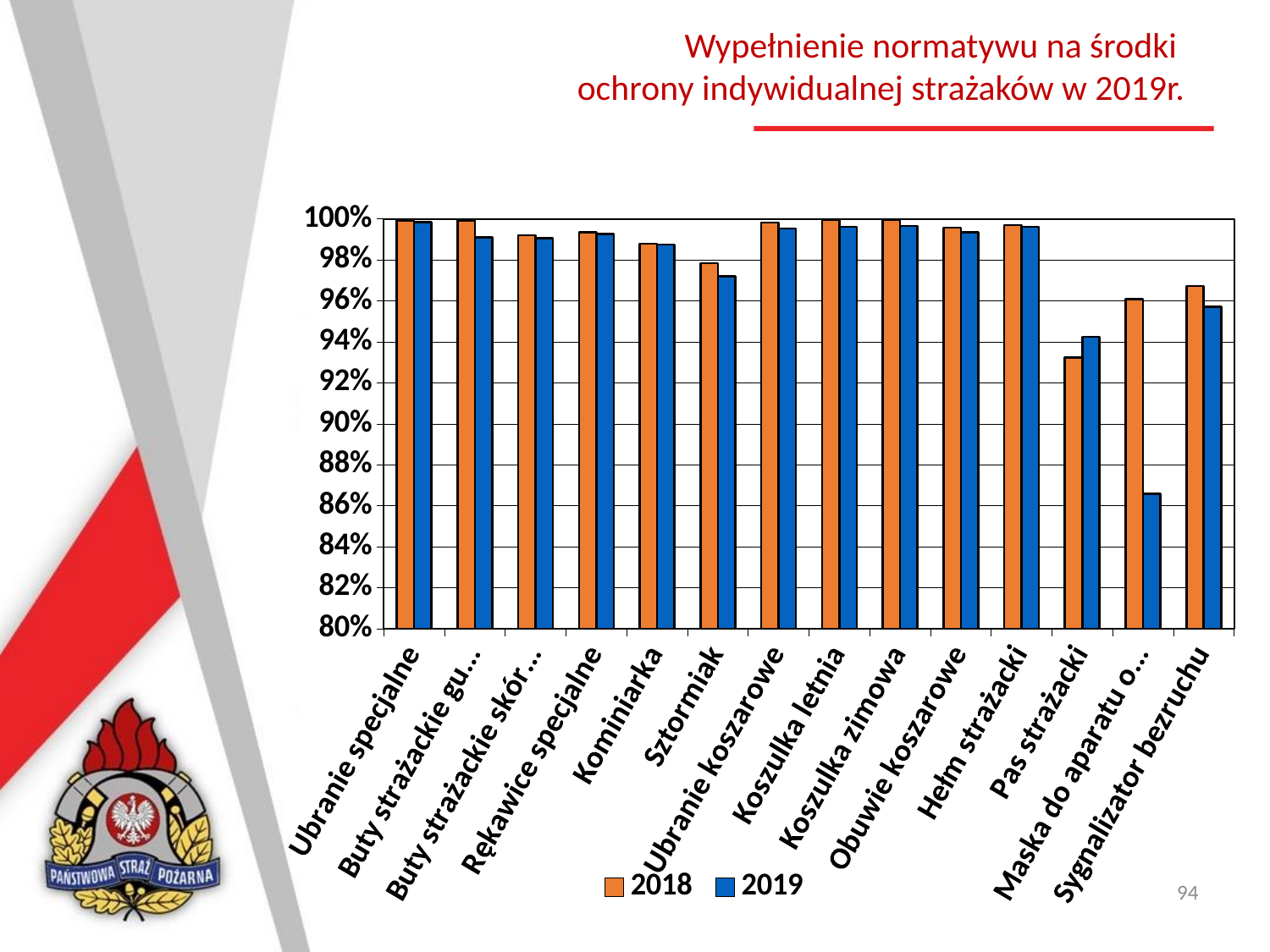
For Pas strażacki, which year has the larger value, 2018 or 2019? 2019 Is the 2018 value for Pas strażacki greater or less than 94%? less Is the 2019 value for Sztormiak greater or less than 98%? less How many categories are shown on the x axis? 14 For Sygnalizator bezruchu, which year has the larger value, 2018 or 2019? 2018 Is the 2019 value for Maska do aparatu o… greater or less than 88%? less What kind of chart is shown on the slide? bar chart How many series does the legend list? 2 What is the title of the slide's chart? Wypełnienie normatywu na środki ochrony indywidualnej strażaków w 2019r. Which category has the lowest value for 2018? Pas strażacki Which colour represents the 2019 series in the legend? blue